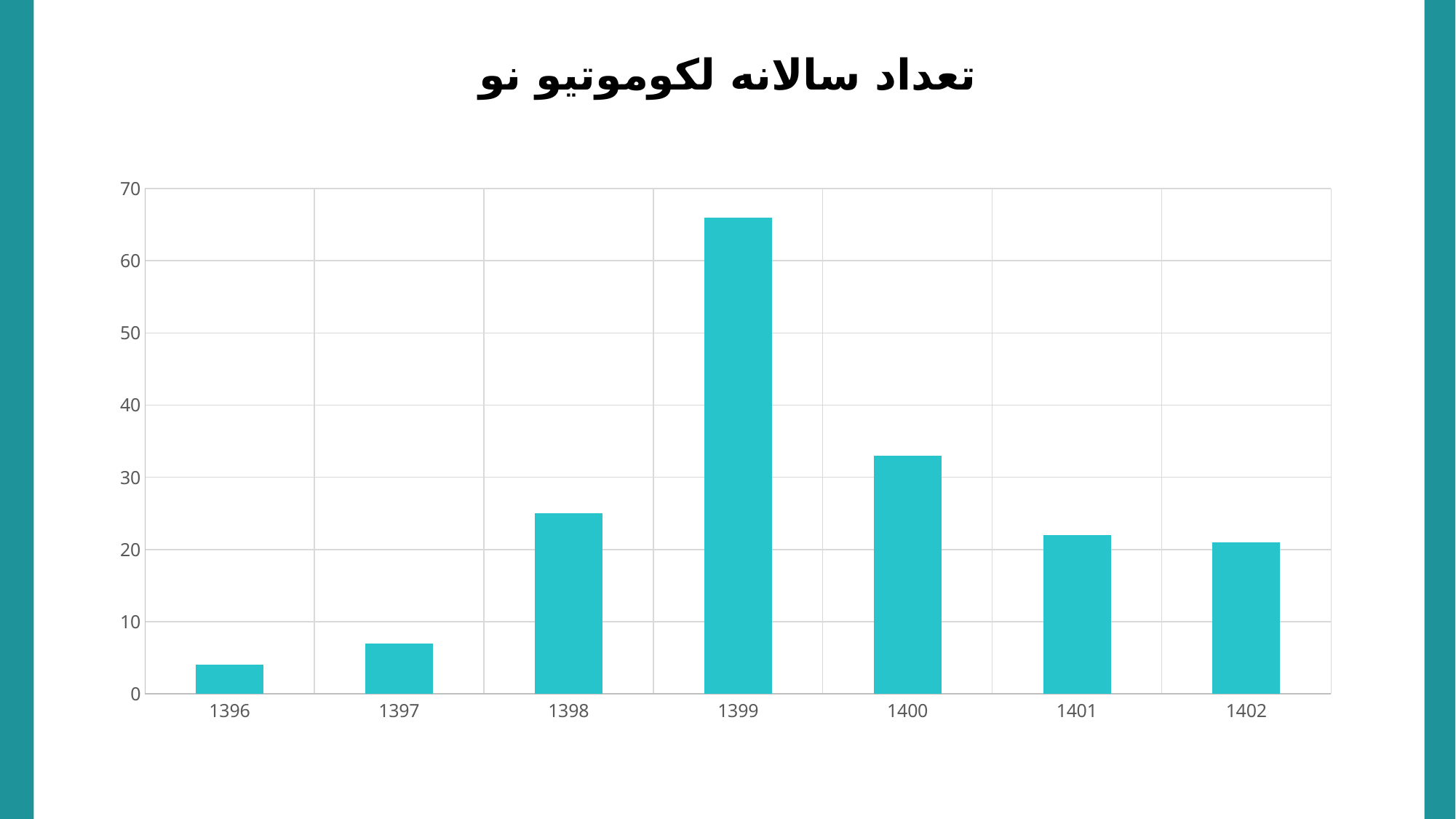
Which is larger, the value for 1398 or the value for 1400? 1400 What kind of chart is shown on the slide? bar chart Is the value for 1399 greater or less than 60? greater Is the value for 1400 greater or less than 30? greater Do the values rise or fall from 1399 to 1402? fall Which year has the highest value in the chart? 1399 Which year has the lowest value in the chart? 1396 Is the value for 1402 greater or less than 30? less How many years are shown on the x axis of the chart? 7 What is the title of the chart? تعداد سالانه لکوموتیو نو